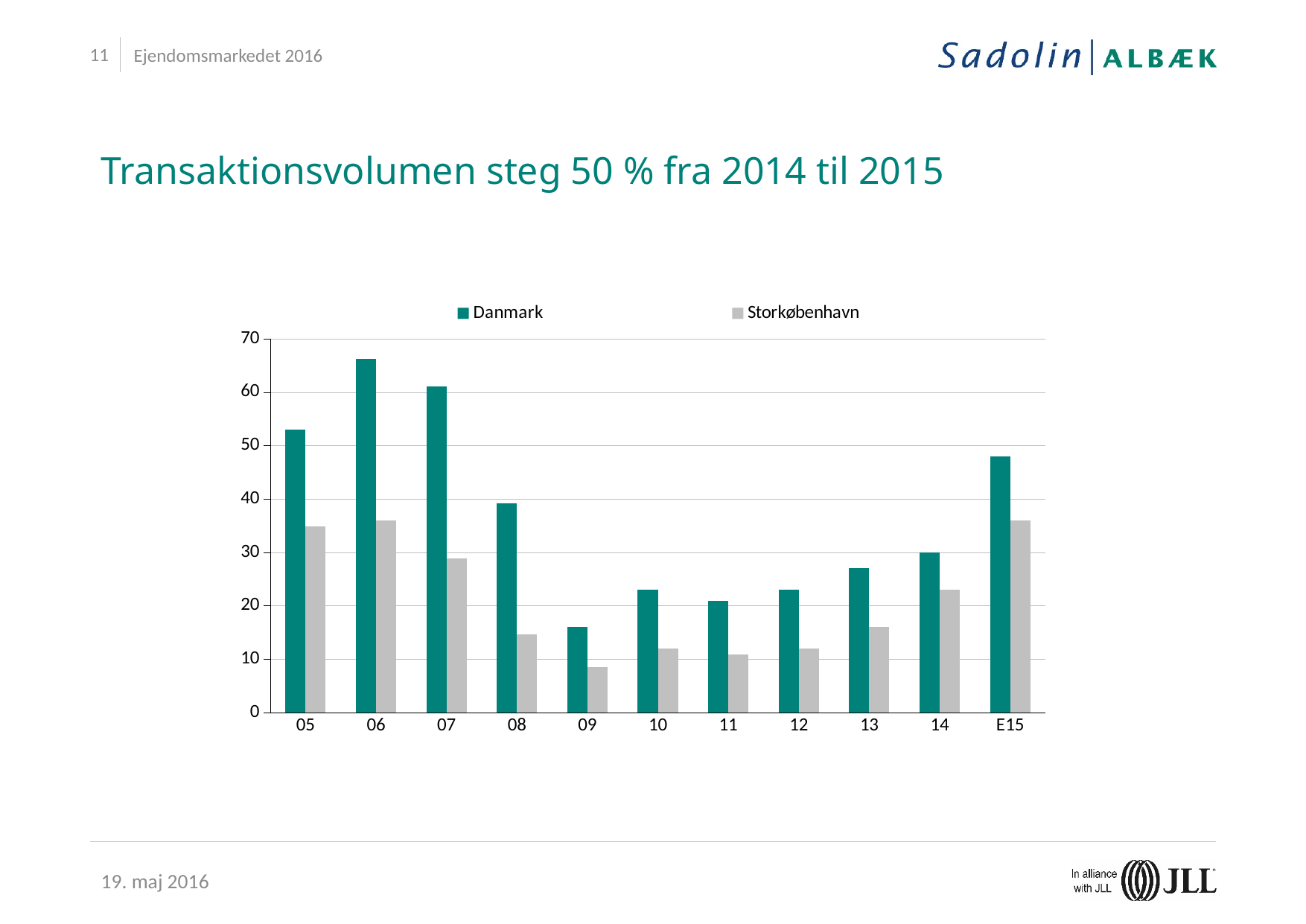
Do the Danmark values rise or fall from 06 to 09? fall Is the Danmark value for 09 greater or less than 20? less How many year categories are shown on the x axis? 11 Is the Danmark value for 06 greater or less than 60? greater Which is larger, the Danmark value for 07 or the Danmark value for 08? 07 In which year is the Danmark value lowest? 09 Is the Storkøbenhavn value for 09 greater or less than 10? less How many series does the legend list? 2 In which year is the Storkøbenhavn value lowest? 09 In which year is the Danmark value highest? 06 What kind of chart is shown on the slide? bar chart